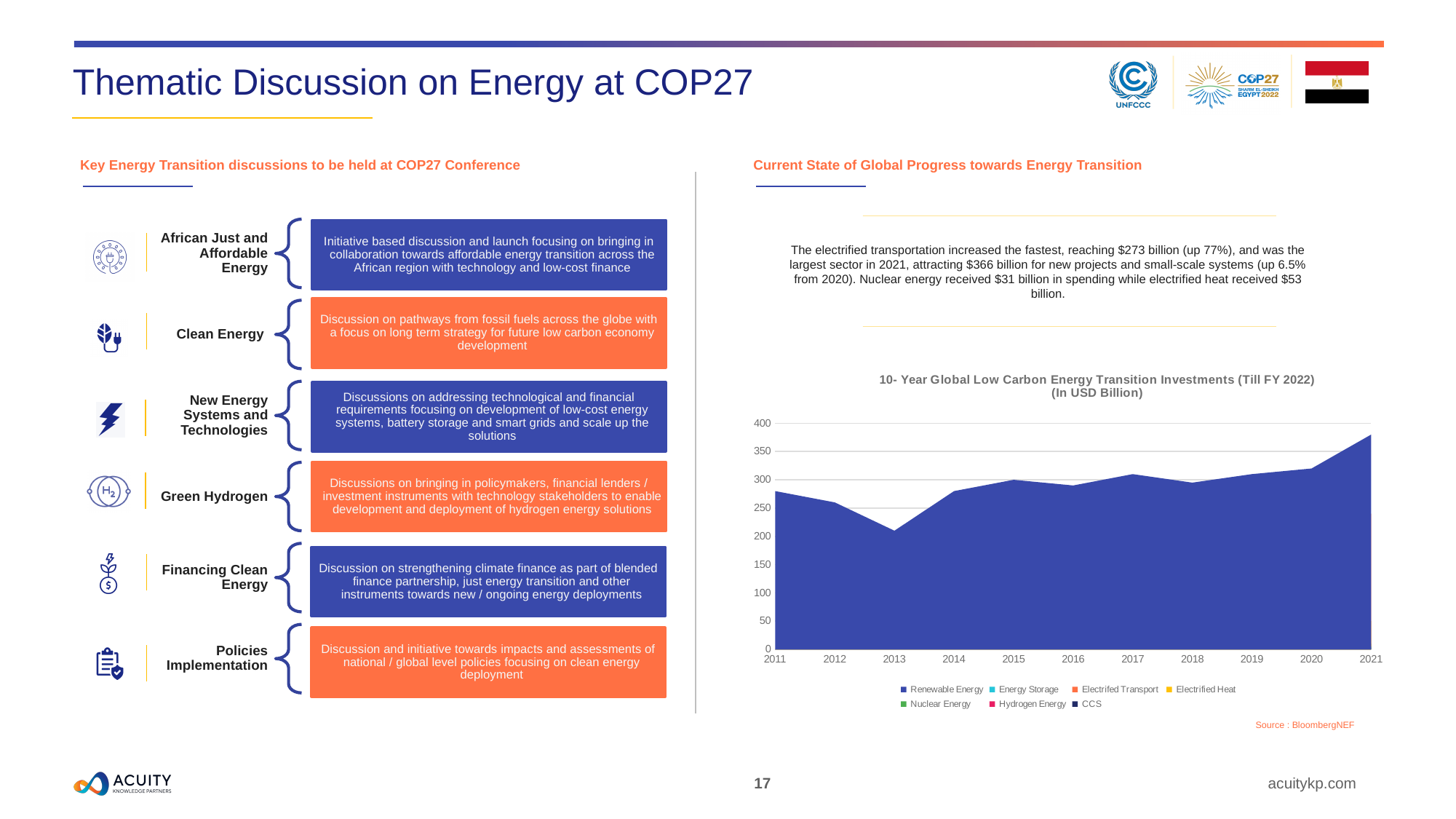
In which year does the investments chart reach its highest value? 2021 How many series does the legend of the investments chart list? 7 Which year has the larger value in the investments chart, 2013 or 2021? 2021 In which year does the investments chart reach its lowest value? 2013 Do the values in the investments chart rise or fall from 2013 to 2021? Rise What kind of chart is the '10- Year Global Low Carbon Energy Transition Investments (Till FY 2022)' chart? Area chart Is the value for 2021 in the investments chart greater or less than 350? greater Is the value for 2013 in the investments chart greater or less than 250? less How many years are plotted along the x axis of the investments chart? 11 What is the unit stated in the title of the investments chart? USD Billion Is the value for 2011 in the investments chart greater or less than 250? greater